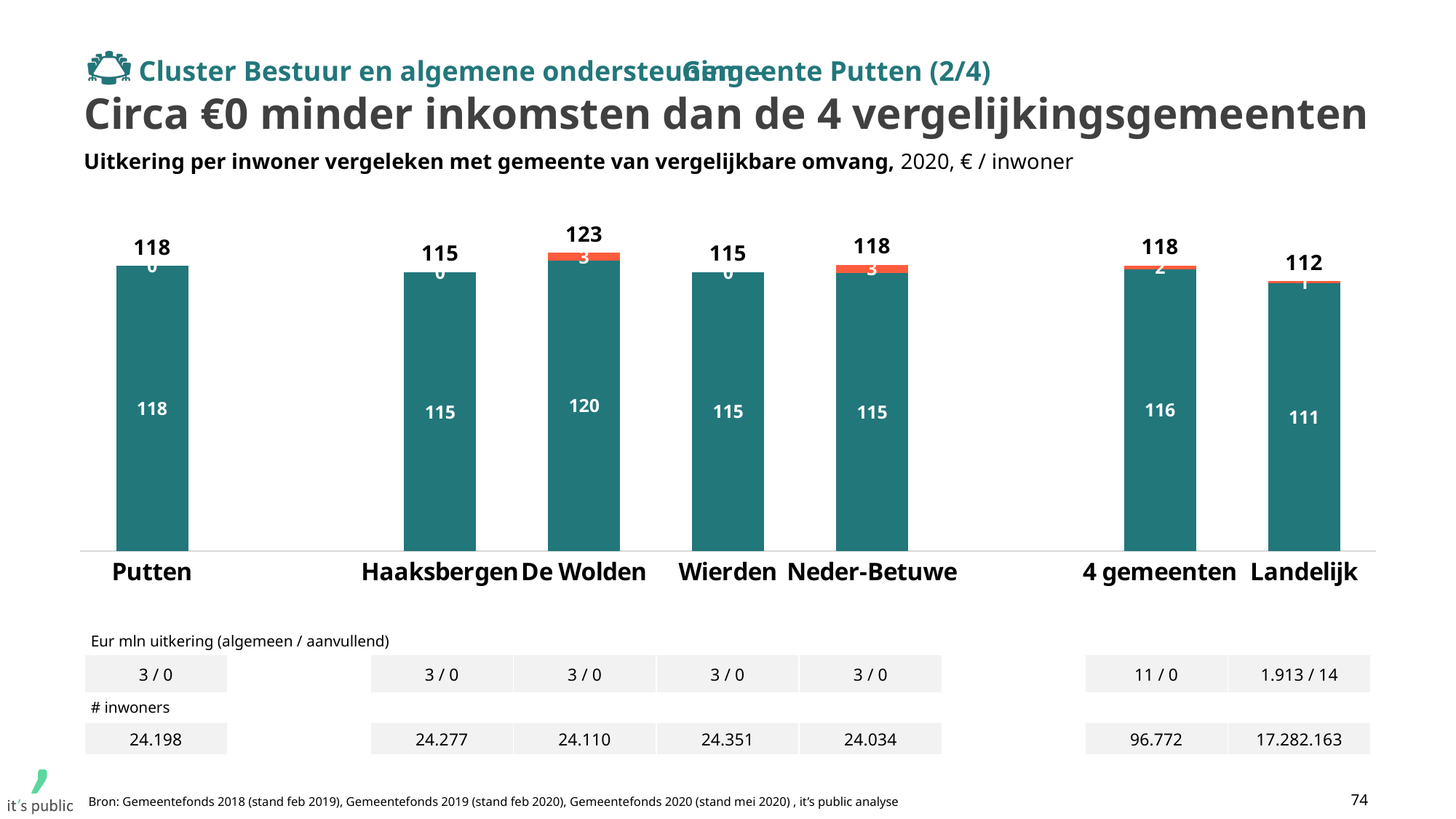
What kind of chart is shown on the slide? Stacked bar chart What is the value of the orange (upper) segment for Neder-Betuwe? 3 What is the total value shown above the bar for Putten? 118 What is the total value shown above the bar for De Wolden? 123 What is the sum of the teal segment (116) and the orange segment (2) for 4 gemeenten? 118 Which category has the highest total value? De Wolden How many categories are shown on the x axis of the chart? 7 What is the difference between the total for De Wolden and the total for Landelijk? 11 What is the value of the teal (lower) segment for 4 gemeenten? 116 Which has a larger total value, Putten or Haaksbergen? Putten What is the value of the teal (lower) segment for Landelijk? 111 Which category has the lowest total value? Landelijk